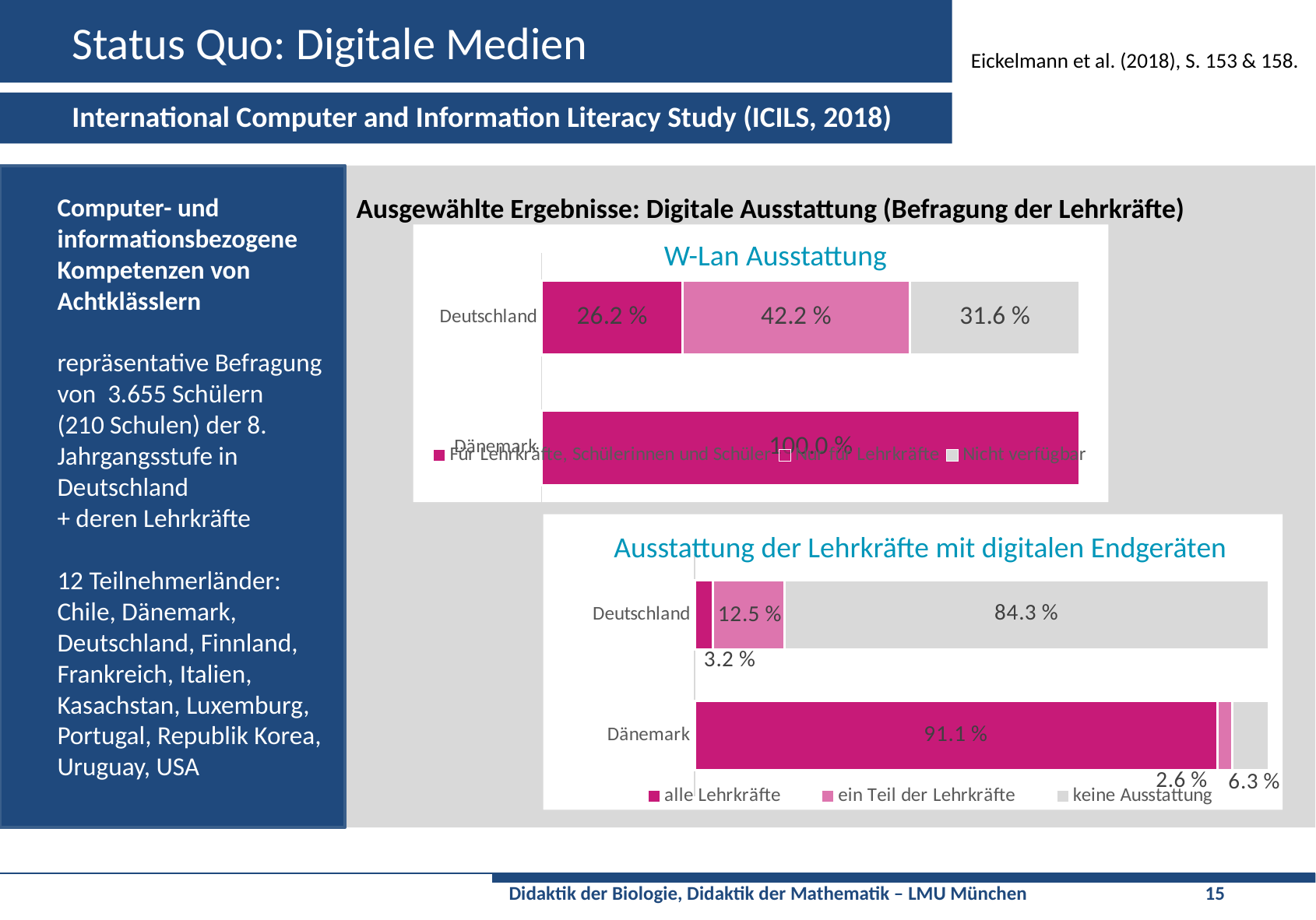
In the 'W-Lan Ausstattung' chart, what is the difference between the 'Nur für Lehrkräfte' and 'Für Lehrkräfte, Schülerinnen und Schüler' values for Deutschland? 16.0 % In the 'W-Lan Ausstattung' chart, what is the value for Dänemark in the 'Für Lehrkräfte, Schülerinnen und Schüler' series? 100.0 % In the 'Ausstattung der Lehrkräfte mit digitalen Endgeräten' chart, how many countries are shown? 2 What kind of chart is the 'Ausstattung der Lehrkräfte mit digitalen Endgeräten' chart? Stacked bar chart In the 'Ausstattung der Lehrkräfte mit digitalen Endgeräten' chart, which country has the larger 'alle Lehrkräfte' value, Deutschland or Dänemark? Dänemark In the 'Ausstattung der Lehrkräfte mit digitalen Endgeräten' chart, what is the value for Deutschland in the 'alle Lehrkräfte' series? 3.2 % In the 'W-Lan Ausstattung' chart, how many series does the legend list? 3 In the 'Ausstattung der Lehrkräfte mit digitalen Endgeräten' chart, what is the value for Dänemark in the 'alle Lehrkräfte' series? 91.1 % In the 'W-Lan Ausstattung' chart, what is the value for Deutschland in the 'Nur für Lehrkräfte' series? 42.2 % In the 'Ausstattung der Lehrkräfte mit digitalen Endgeräten' chart, what is the difference between the 'keine Ausstattung' values for Deutschland and Dänemark? 78.0 % In the 'W-Lan Ausstattung' chart, what is the value for Deutschland in the 'Nicht verfügbar' series? 31.6 % In the 'Ausstattung der Lehrkräfte mit digitalen Endgeräten' chart, what is the value for Deutschland in the 'keine Ausstattung' series? 84.3 %